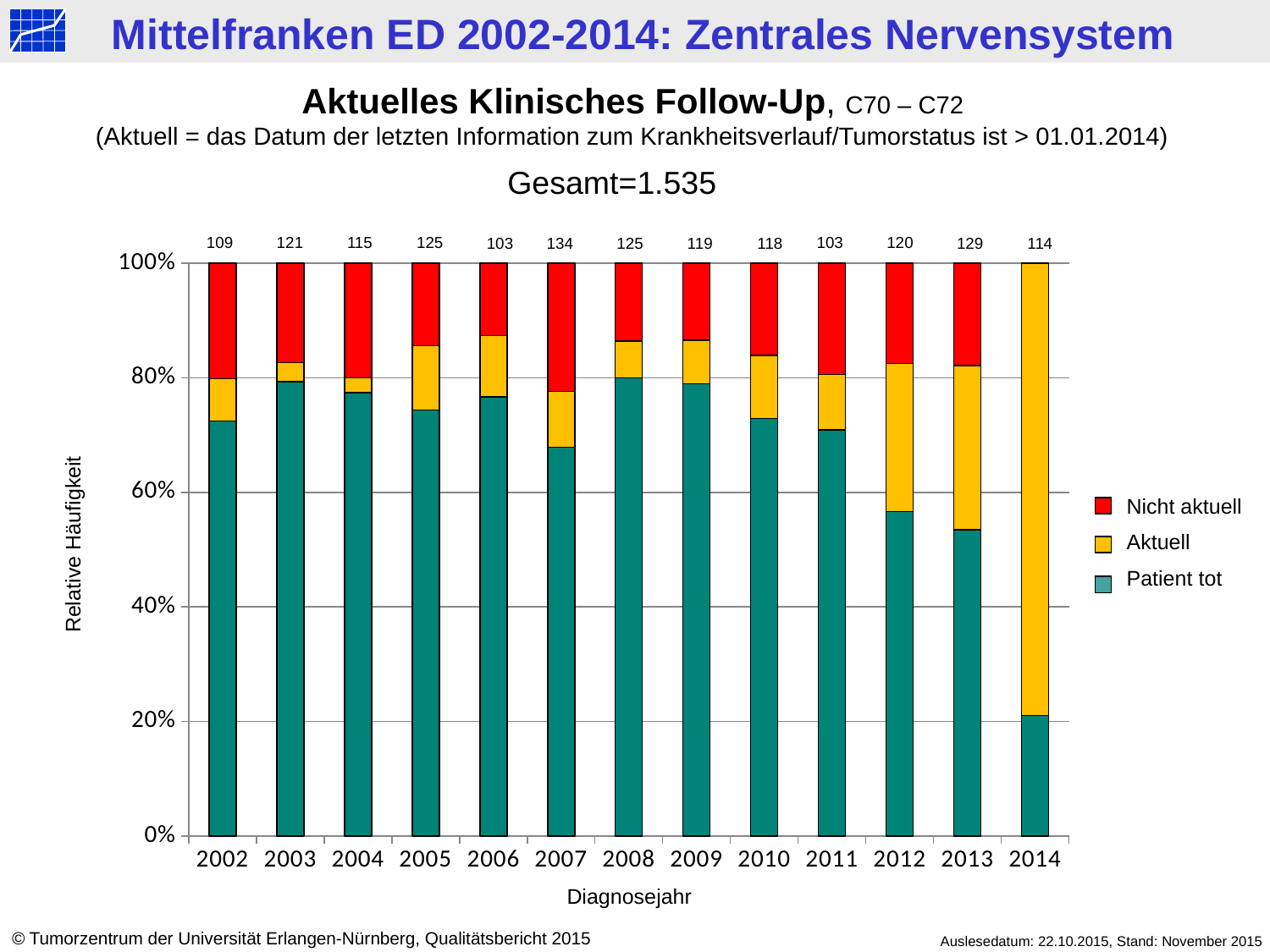
How many series does the legend list? 3 Is the 'Patient tot' share for 2002 greater or less than 60%? greater What is the label of the x axis? Diagnosejahr What is the difference between the numbers printed above the bars for 2007 and 2006? 31 Which diagnosis year has the highest number printed above its bar? 2007 How many diagnosis years are shown on the x axis? 13 What is the number printed above the bar for 2014? 114 What is the number printed above the bar for 2002? 109 What is the number printed above the bar for 2007? 134 Is the 'Patient tot' share for 2014 greater or less than 40%? less Which has the larger number printed above its bar, 2003 or 2004? 2003 What kind of chart is shown on the slide? stacked bar chart